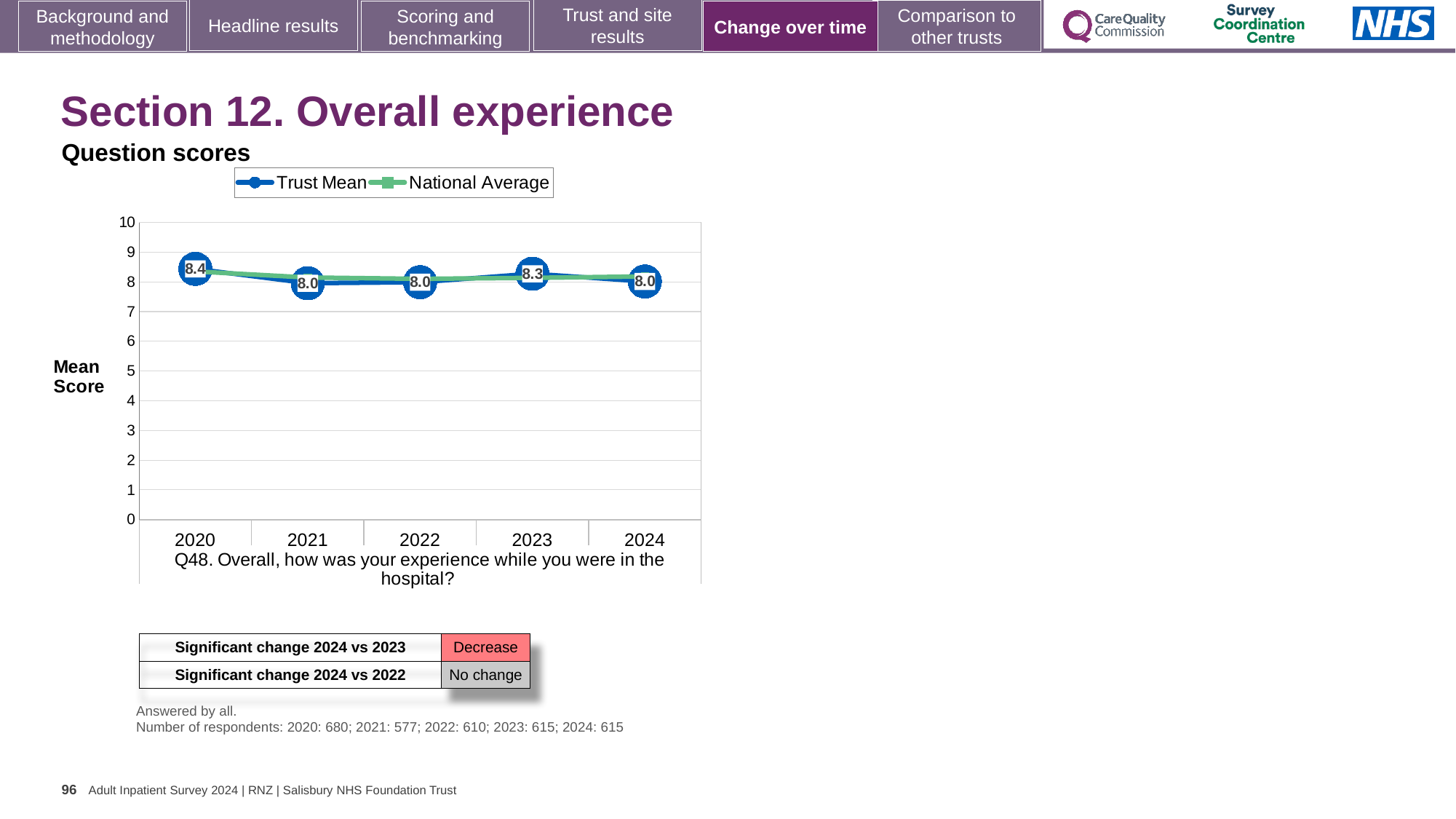
What is the Trust Mean score for 2020? 8.4 What is the Trust Mean score for 2023? 8.3 How many series does the legend list? 2 Is the Trust Mean score for 2022 greater or less than 9? less What kind of chart is shown? line chart What is the difference between the Trust Mean scores for 2020 and 2021? 0.4 In which year is the Trust Mean score highest? 2020 Does the Trust Mean score rise or fall from 2020 to 2021? fall What is the Trust Mean score for 2024? 8.0 Which year has the larger Trust Mean score, 2020 or 2023? 2020 What are the two series named in the legend? Trust Mean and National Average How many years are plotted on the x axis? 5